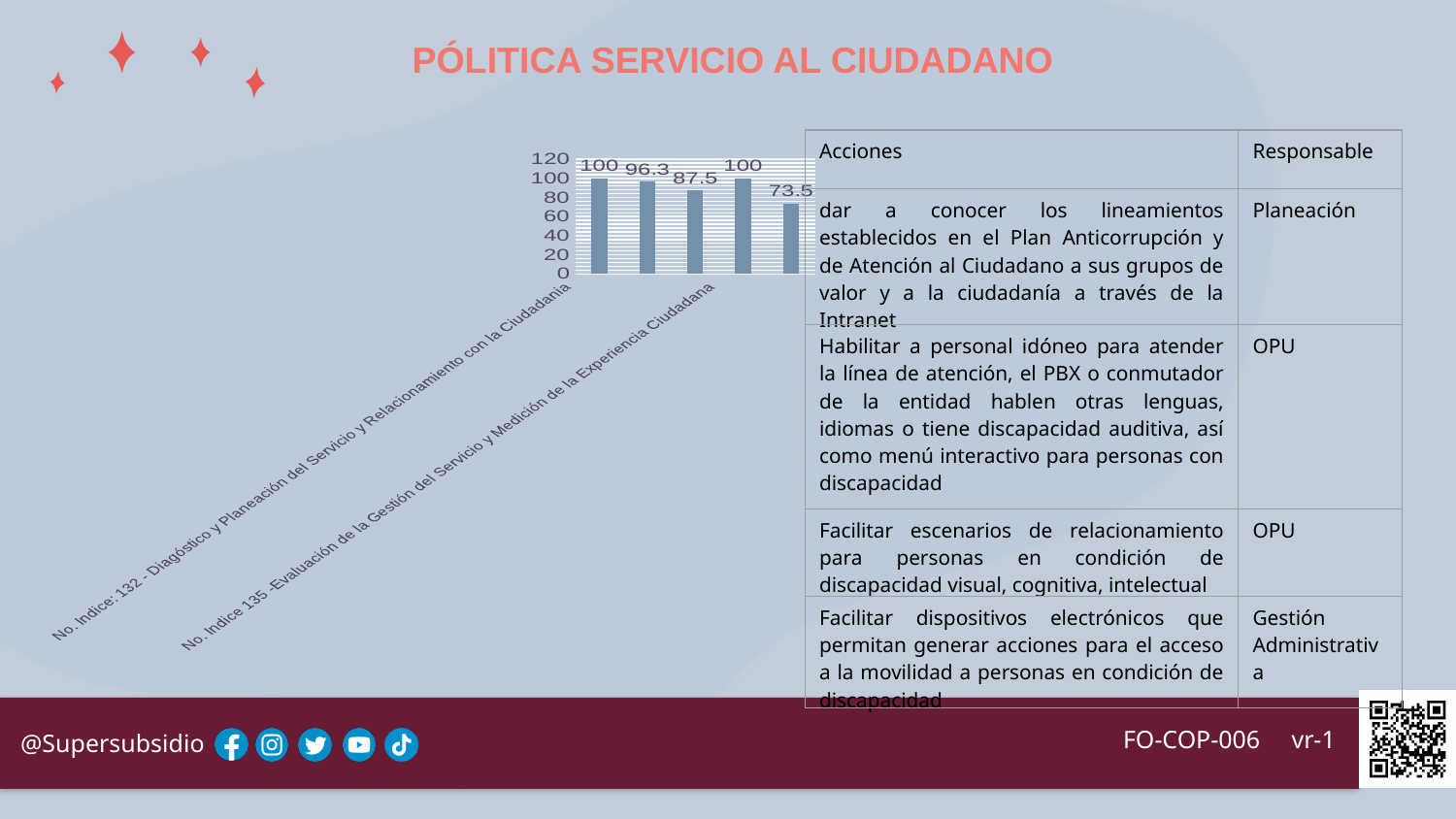
What is the highest value shown in the chart? 100 What is the value of the third bar from the left in the chart? 87.5 What is the value of the rightmost (last) bar in the chart? 73.5 Is the value of the last bar greater or less than 80? less Which is larger, the second bar or the third bar? the second bar (96.3) What is the difference between the first bar (100) and the last bar (73.5)? 26.5 What kind of chart is shown on the left of the slide? bar chart How many bars does the chart show? 5 What is the maximum value shown on the chart's vertical axis? 120 What is the difference between the second bar (96.3) and the third bar (87.5)? 8.8 What is the value of the second bar from the left in the chart? 96.3 What is the lowest value shown in the chart? 73.5